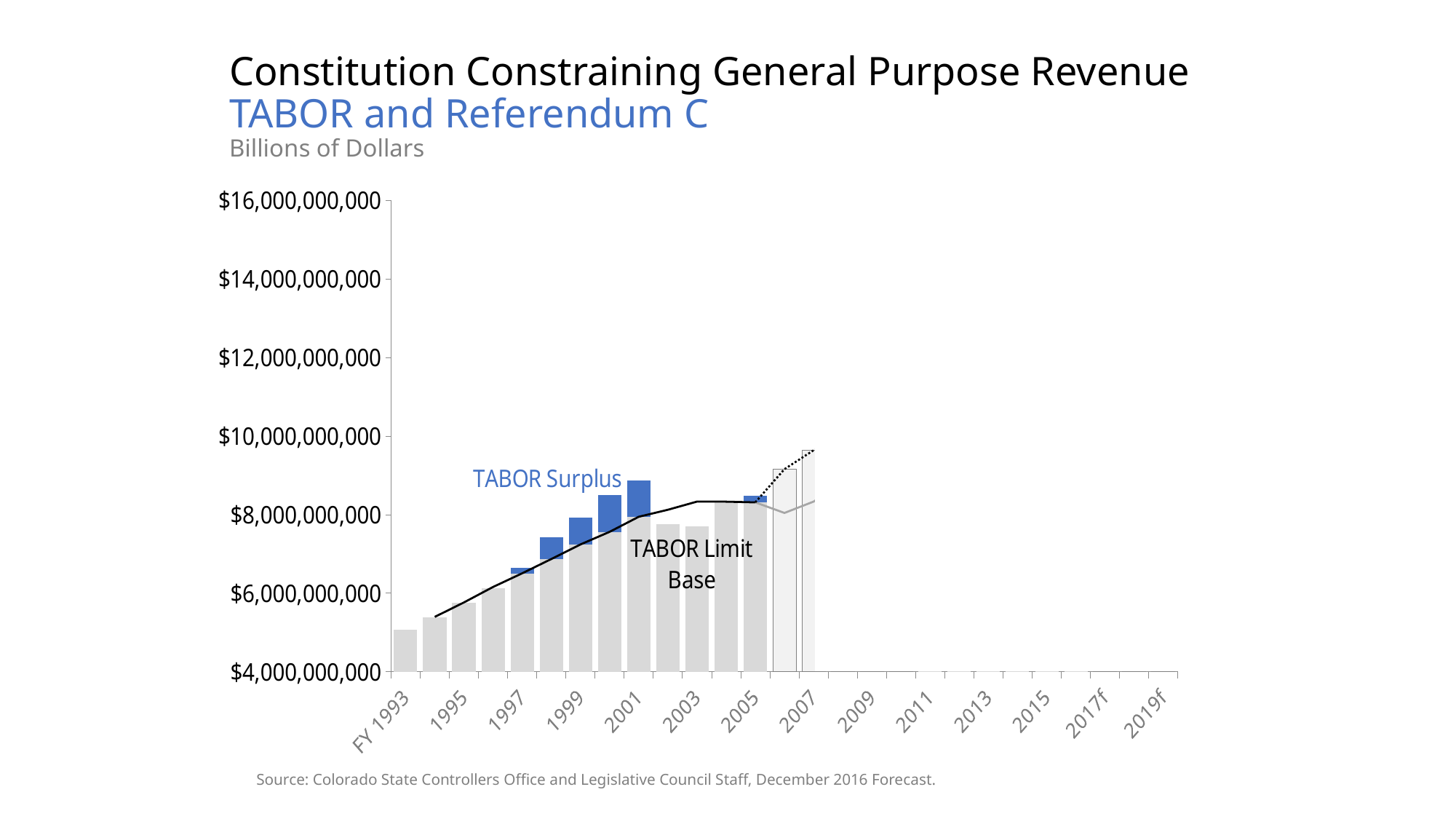
What is the title of the chart? Constitution Constraining General Purpose Revenue What unit does the chart's subtitle say the values are in? Billions of Dollars Which is larger, the bar for FY 1993 or the bar for 1995? 1995 Is the value for FY 1993 greater or less than $6,000,000,000? less Which is larger, the bar for 2001 or the bar for 2003? 2001 Is the value for 2001 greater or less than $8,000,000,000? greater How many year labels are shown on the x axis? 14 Is the value for 1999 greater or less than $6,000,000,000? greater Do the bars rise or fall from FY 1993 to 2001? rise What kind of chart is shown on the slide? combination bar and line chart Which year has the lowest bar on the chart? FY 1993